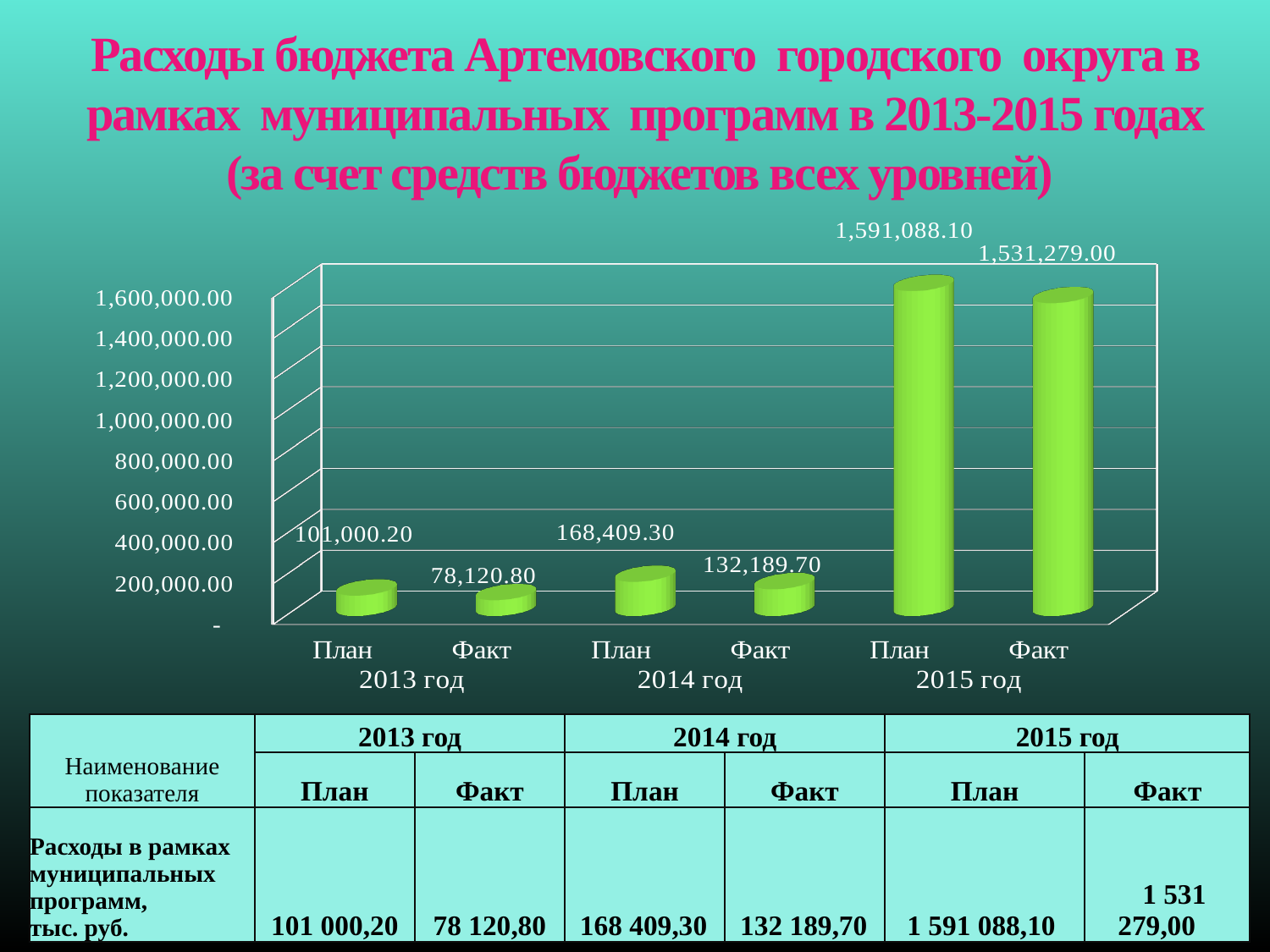
Which bar has the lowest value on the chart? Факт 2013 год Is the value of the План bar for 2015 год greater or less than 1,400,000.00? greater What is the difference between the План and Факт values for 2015 год? 59,809.10 What is the value of the Факт bar for 2015 год? 1,531,279.00 Do the План values rise or fall from 2013 год to 2015 год? rise How many bars are plotted on the chart? 6 What is the difference between the План and Факт values for 2014 год? 36,219.60 What is the value of the Факт bar for 2014 год? 132,189.70 What is the value of the План bar for 2013 год? 101,000.20 What kind of chart is shown on the slide? bar chart Which is larger, the Факт value for 2013 год or the Факт value for 2014 год? Факт 2014 год Which bar has the highest value on the chart? План 2015 год